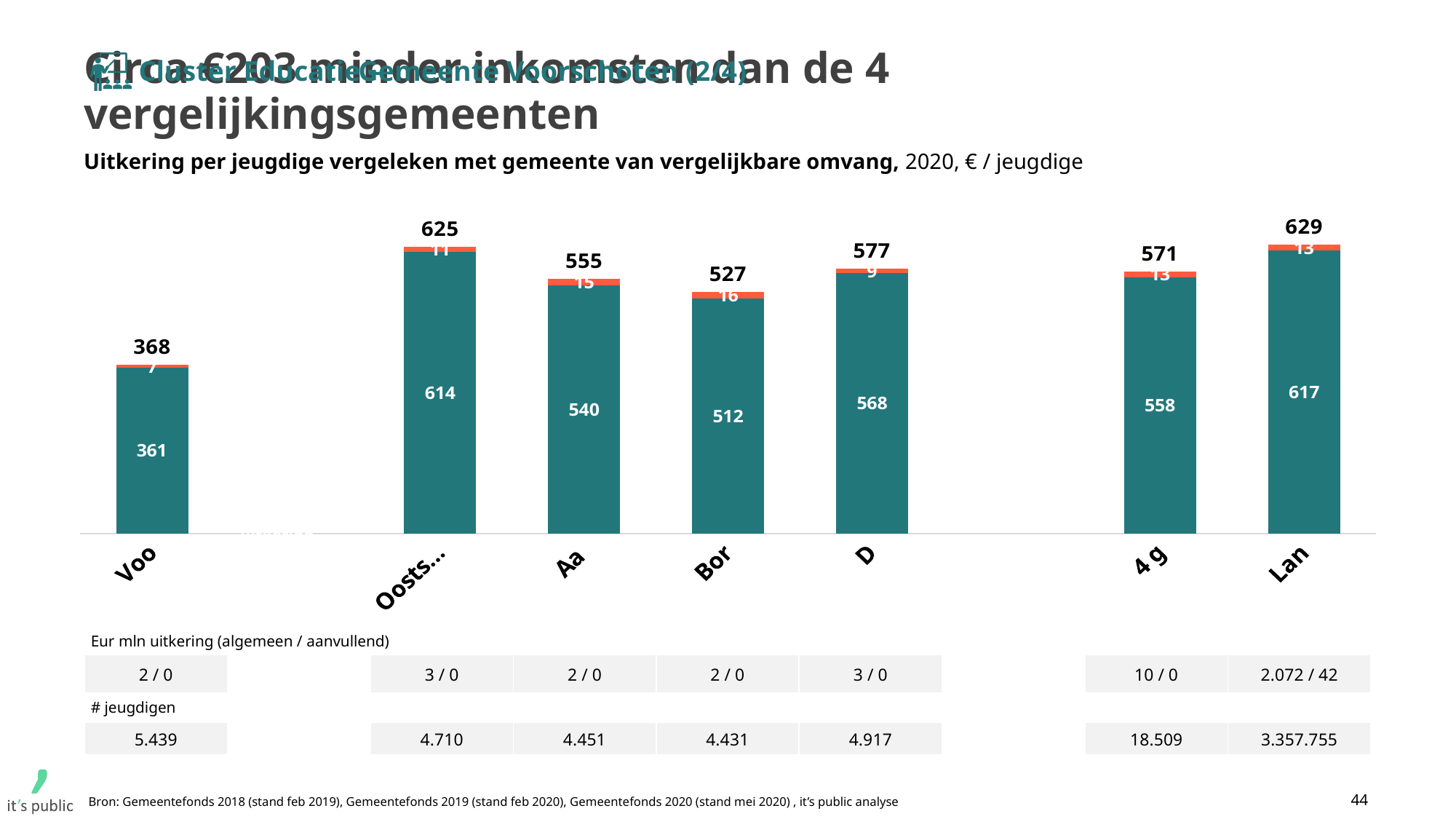
What is the value of the large teal segment in the bar for Lan? 617 How many bars are shown in the chart? 7 Which category has the highest total value? Lan What is the difference between the total for Lan and the total for Voo? 261 What kind of chart is shown on the slide? Stacked bar chart Which category has the lowest total value? Voo In what unit are the chart values expressed, according to the subtitle? € / jeugdige What is the value of the large teal segment in the bar for D? 568 What is the total value shown above the bar for Voo? 368 What is the total value shown above the bar for 4 g? 571 Which has a larger total, Aa or Bor? Aa What is the difference between the total for Oosts... and the total for Aa? 70